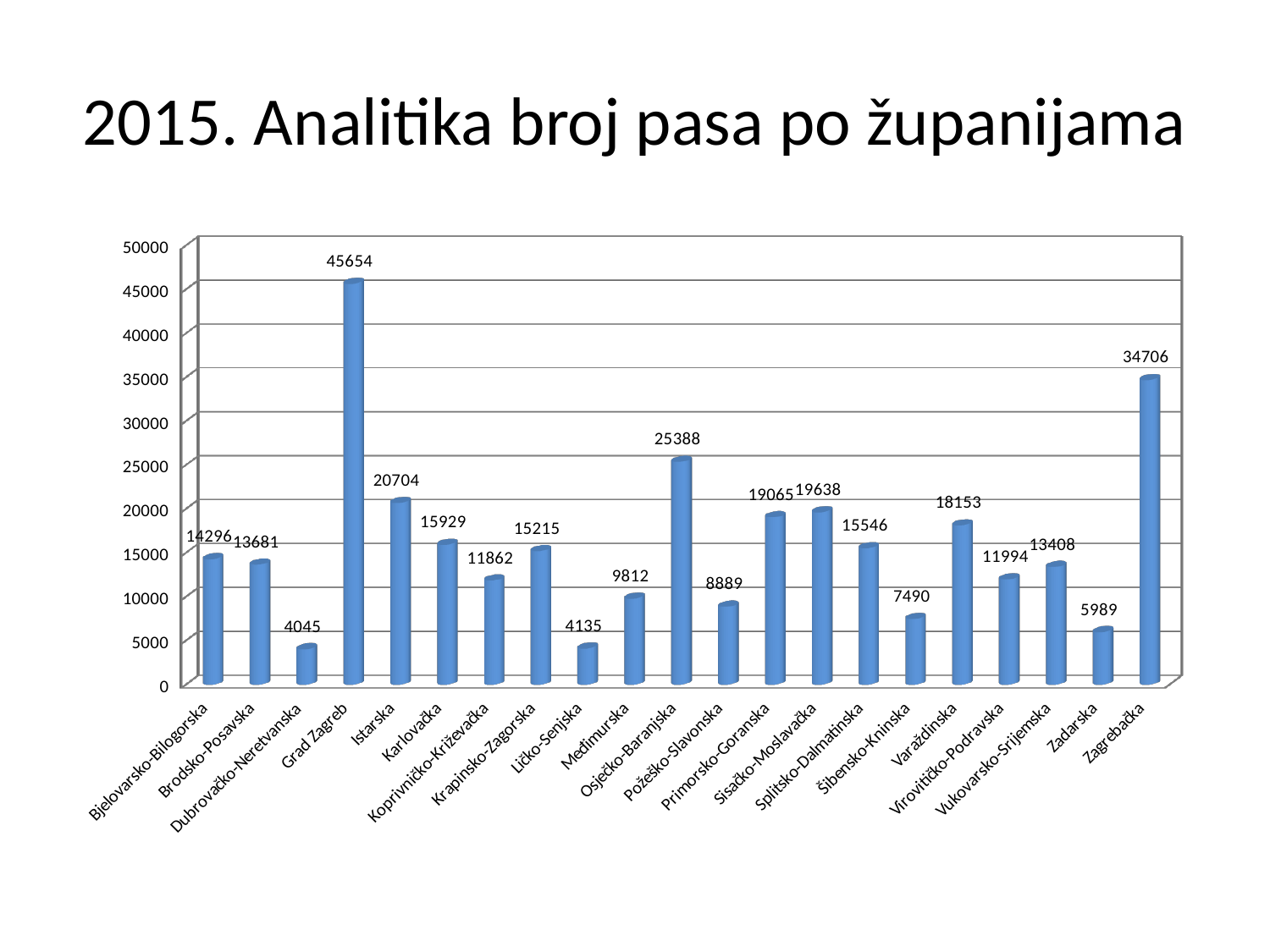
Which is larger, the value for Sisačko-Moslavačka or Primorsko-Goranska? Sisačko-Moslavačka What is the value for Grad Zagreb? 45654 What is the value for Osječko-Baranjska? 25388 What is the difference between the values for Osječko-Baranjska and Istarska? 4684 Is the value for Varaždinska greater or less than 15000? greater Which county has the highest number of dogs? Grad Zagreb What is the value for Šibensko-Kninska? 7490 What kind of chart is shown on the slide? bar chart What is the difference between the values for Grad Zagreb and Zagrebačka? 10948 How many counties are shown on the chart? 21 What is the title of the slide? 2015. Analitika broj pasa po županijama Which county has the lowest number of dogs? Dubrovačko-Neretvanska